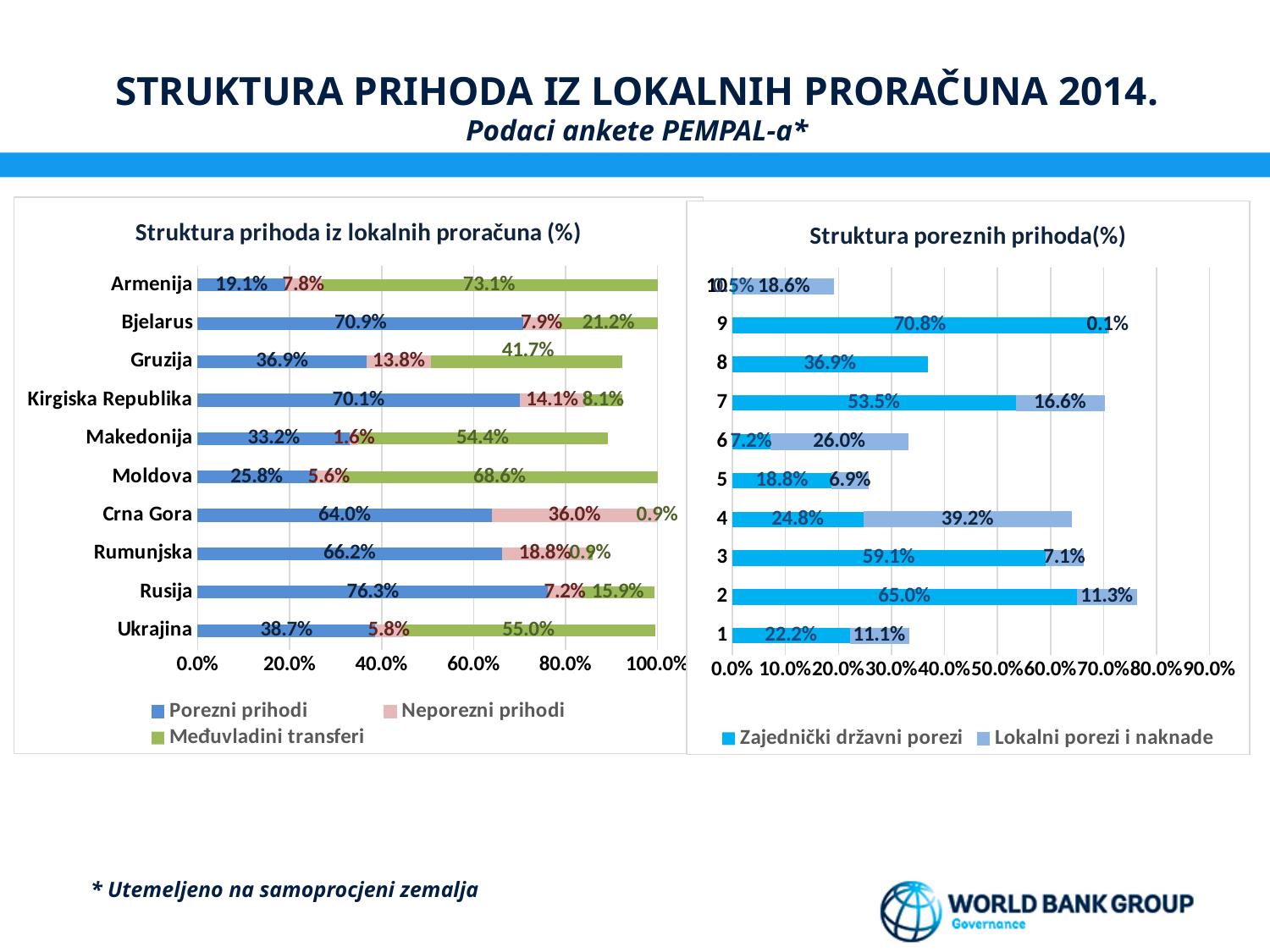
In the right chart 'Struktura poreznih prihoda(%)', what is the total of the stacked bar for category 2? 76.3% In the left chart 'Struktura prihoda iz lokalnih proračuna (%)', which is larger: the Neporezni prihodi value for Crna Gora or for Rumunjska? Crna Gora In the left chart 'Struktura prihoda iz lokalnih proračuna (%)', how many countries are shown? 10 In the left chart 'Struktura prihoda iz lokalnih proračuna (%)', what is the Porezni prihodi value for Rusija? 76.3% In the left chart 'Struktura prihoda iz lokalnih proračuna (%)', what is the difference between the Porezni prihodi values of Bjelarus and Gruzija? 34.0% In the left chart 'Struktura prihoda iz lokalnih proračuna (%)', what is the Međuvladini transferi value for Armenija? 73.1% In the right chart 'Struktura poreznih prihoda(%)', what is the Zajednički državni porezi value for category 9? 70.8% In the left chart 'Struktura prihoda iz lokalnih proračuna (%)', how many series does the legend list? 3 In the right chart 'Struktura poreznih prihoda(%)', what is the Lokalni porezi i naknade value for category 4? 39.2% In the left chart 'Struktura prihoda iz lokalnih proračuna (%)', which country has the lowest Neporezni prihodi value? Makedonija What kind of chart is the right chart 'Struktura poreznih prihoda(%)'? Stacked bar chart In the left chart 'Struktura prihoda iz lokalnih proračuna (%)', which country has the highest Porezni prihodi value? Rusija